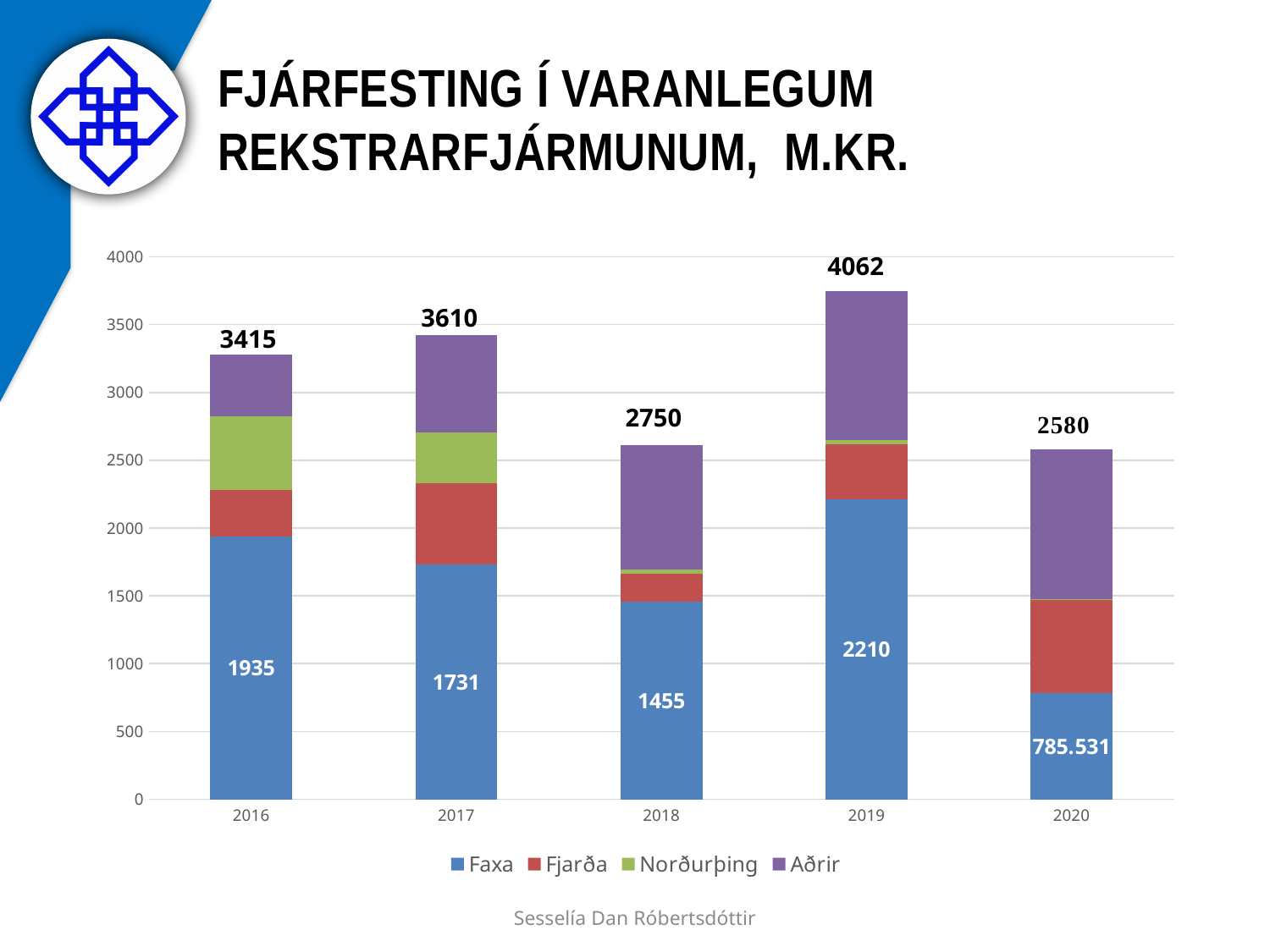
Which year has the lowest Faxa value? 2020 What is the Faxa value for 2016? 1935 What is the difference between the Faxa values for 2016 and 2017? 204 Is the top of the stacked bar for 2019 greater or less than 3500? greater How many series does the legend list? 4 What total is printed above the 2018 bar? 2750 Which year has the highest Faxa value? 2019 Is the Faxa value larger in 2017 or in 2018? 2017 What is the Faxa value for 2020? 785.531 What is the Faxa value for 2019? 2210 What total is printed above the 2019 bar? 4062 How many years are shown on the x axis? 5